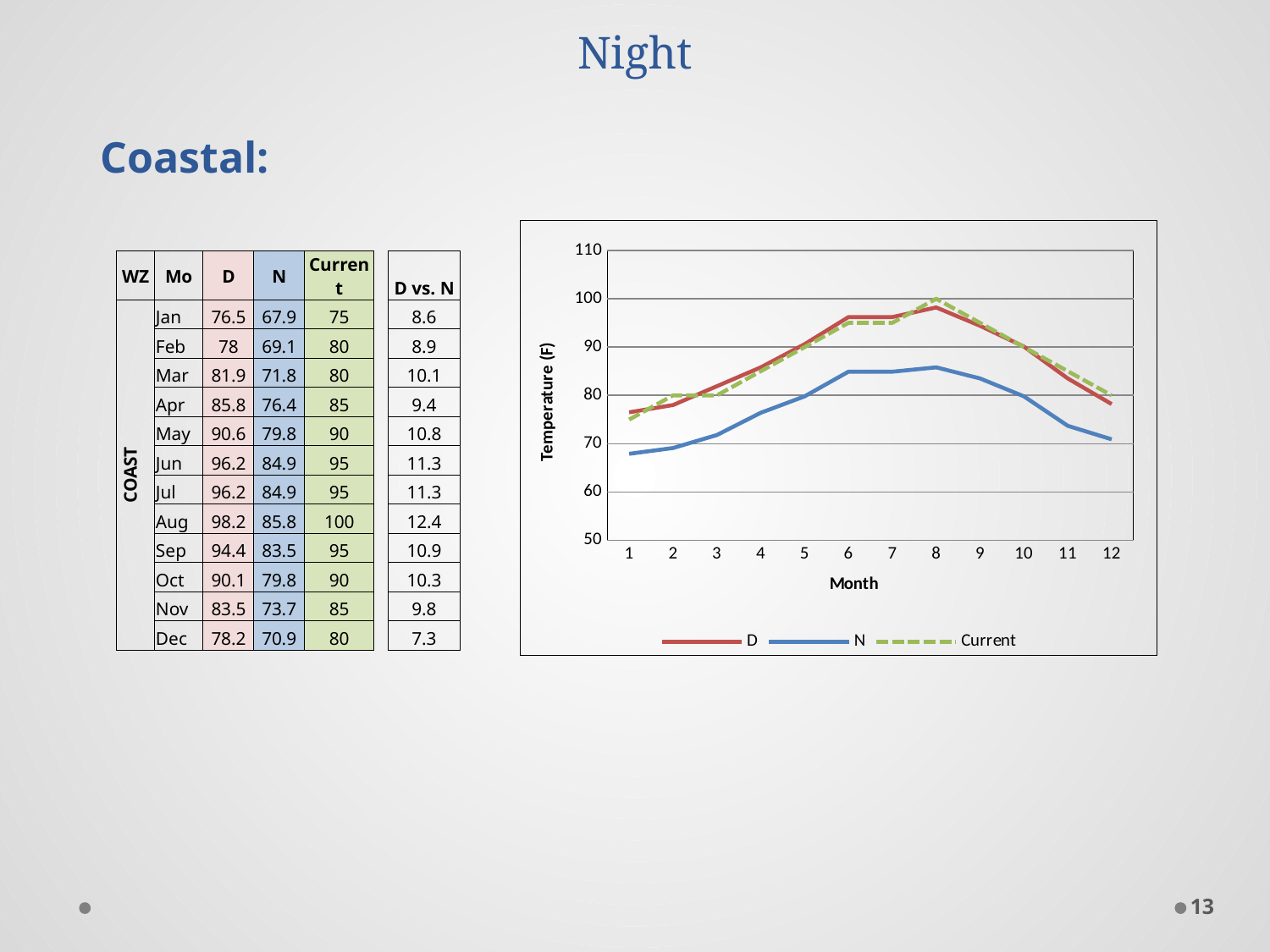
What is the title of the chart's vertical axis? Temperature (F) What kind of chart is shown on the slide? line chart Is the value of the N series at month 8 greater or less than 90? less In which month is the N series at its lowest value? 1 Do the D series values rise or fall from month 8 to month 12? fall How many months are plotted along the x axis of the chart? 12 At month 8, which series is higher, D or Current? Current According to the table, what is the difference between D and N for Aug (D vs. N)? 12.4 According to the table, what is the Current value for Aug? 100 In which month does the D series reach its highest value? 8 How many series does the chart legend list? 3 Is the value of the D series at month 6 greater or less than 90? greater